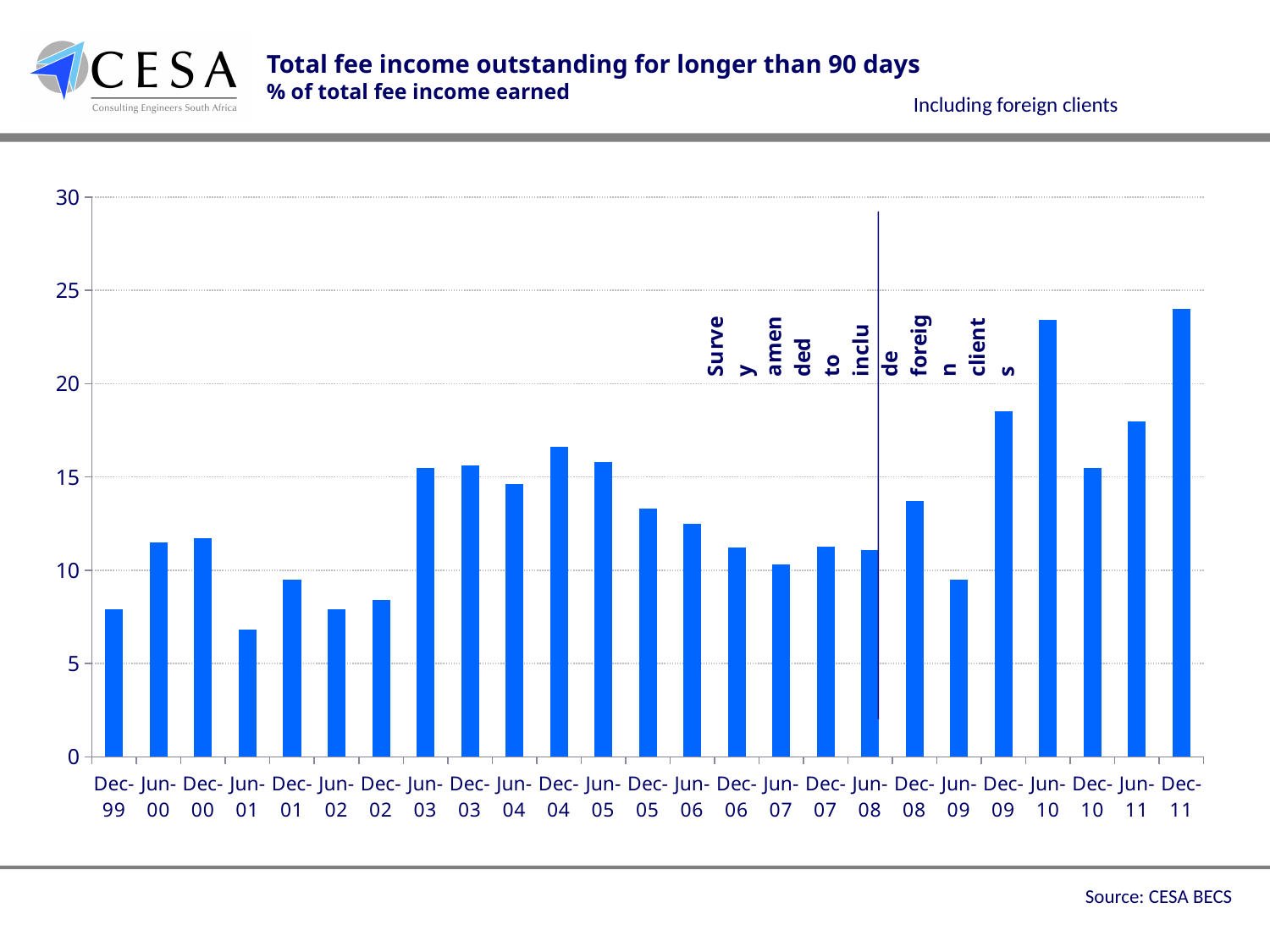
What kind of chart is shown on the slide? Bar chart Is the value for Jun-03 greater or less than 15? greater Do the values rise or fall from Dec-05 to Jun-07? fall What is the source cited for the chart? CESA BECS Is the value for Dec-99 greater or less than 10? less How many bars (periods) are plotted in the chart? 25 Which is larger, the value for Jun-09 or the value for Dec-09? Dec-09 What is the title of the chart? Total fee income outstanding for longer than 90 days Which period has the lowest value in the chart? Jun-01 Which is larger, the value for Jun-10 or the value for Dec-10? Jun-10 Is the value for Dec-08 greater or less than 15? less